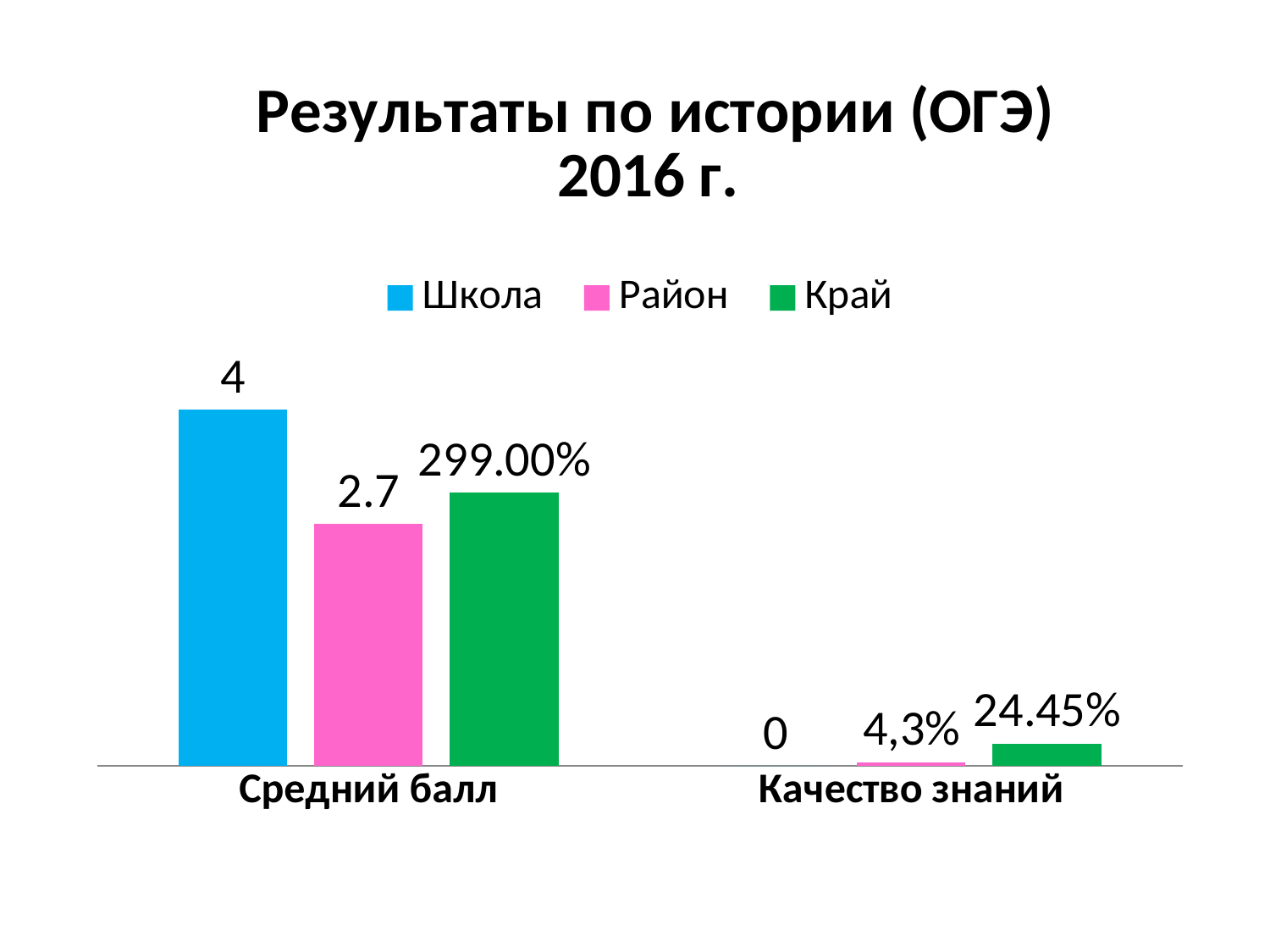
Which series has the lowest value in the Качество знаний category? Школа In the Качество знаний category, which is larger: Район or Край? Край What is the title of the chart? Результаты по истории (ОГЭ) 2016 г. What is the value for Школа in the Качество знаний category? 0 What is the difference between the Школа and Район values in the Средний балл category? 1.3 What is the value for Край in the Качество знаний category? 24.45% What is the value for Район in the Качество знаний category? 4,3% What data label is shown for Край in the Средний балл category? 299.00% How many series does the legend list? 3 Which series has the tallest bar in the Средний балл category? Школа What is the value for Район in the Средний балл category? 2.7 What is the value for Школа in the Средний балл category? 4